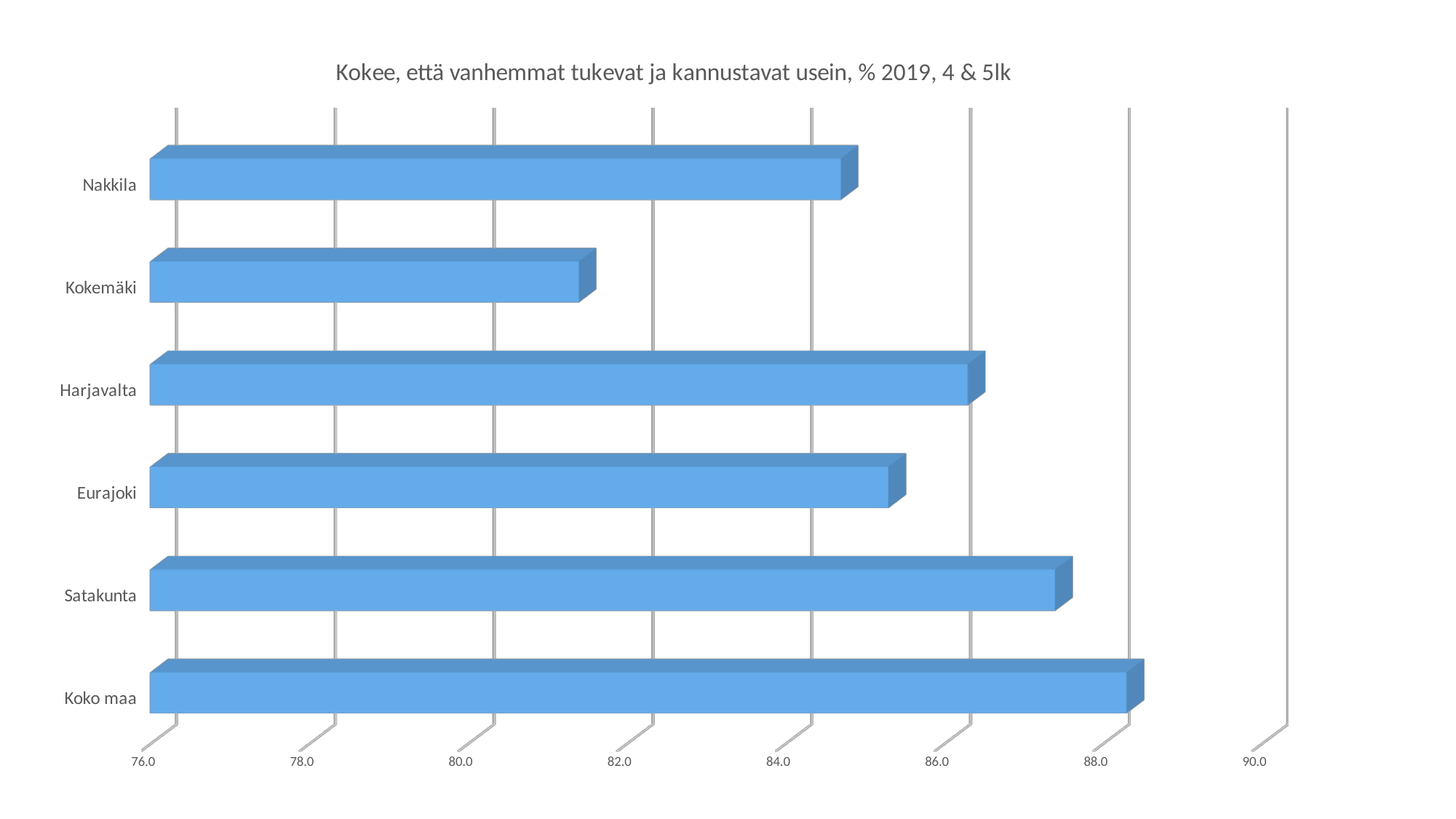
Is the value for Eurajoki greater or less than 86.0? less Is the value for Satakunta greater or less than 88.0? less Is the value for Kokemäki greater or less than 82.0? less Which category has the highest value? Koko maa Which category has the lowest value? Kokemäki What is the title of the chart? Kokee, että vanhemmat tukevat ja kannustavat usein, % 2019, 4 & 5lk What kind of chart is shown on the slide? bar chart How many categories are plotted in the chart? 6 Which has the larger value, Satakunta or Nakkila? Satakunta Which has the larger value, Harjavalta or Eurajoki? Harjavalta